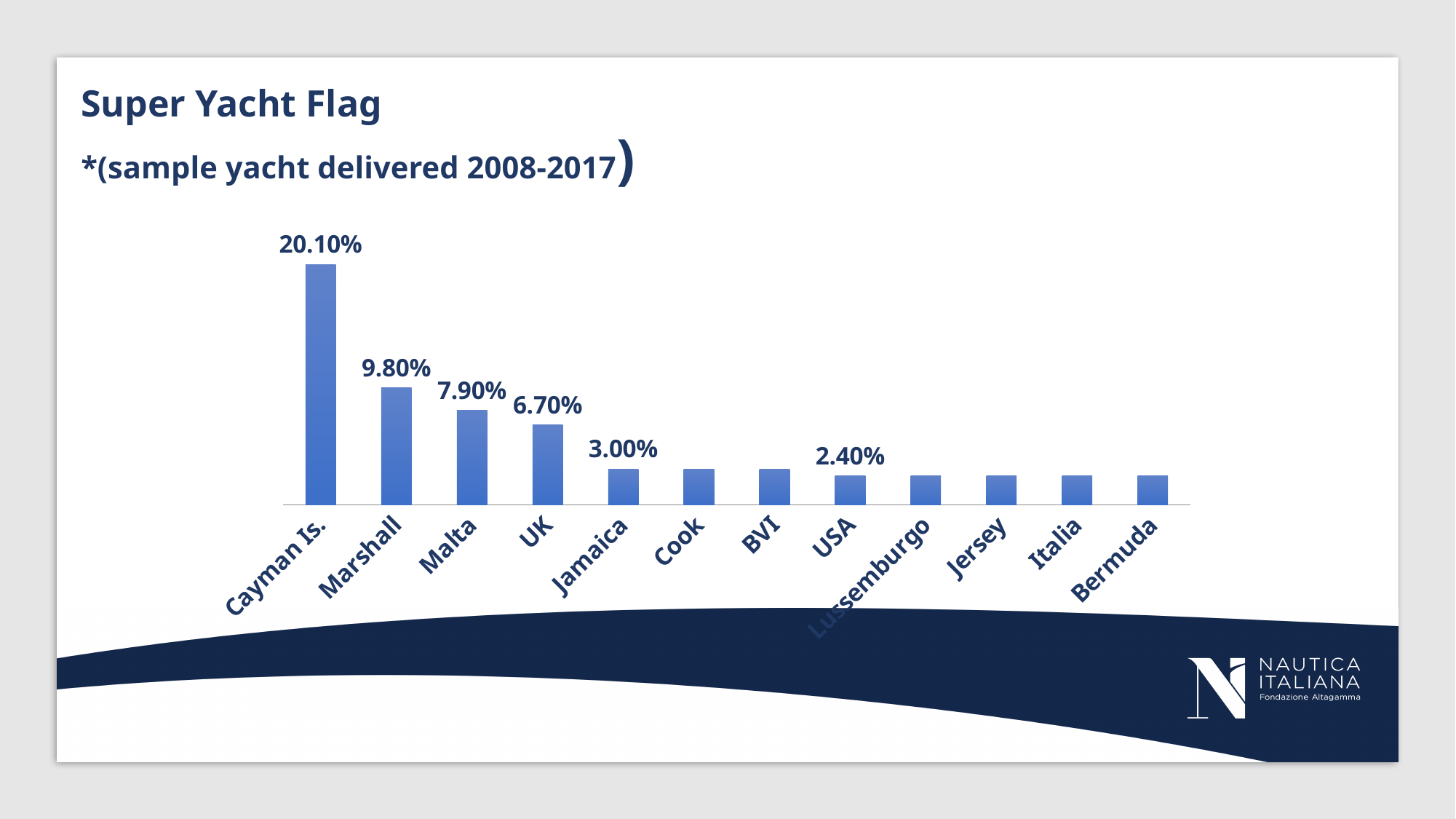
What is the value for Cayman Is.? 20.10% How many flags are shown on the chart? 12 What is the value for USA? 2.40% What kind of chart is shown on the slide? Bar chart What is the value for Marshall? 9.80% What is the value for Malta? 7.90% Which flag has the highest share? Cayman Is. What is the difference between the values for Cayman Is. and Marshall? 10.30% What is the value for Jamaica? 3.00% What is the value for UK? 6.70% Do the values rise or fall from left to right across the chart? Fall Which is larger, the value for Marshall or the value for Malta? Marshall